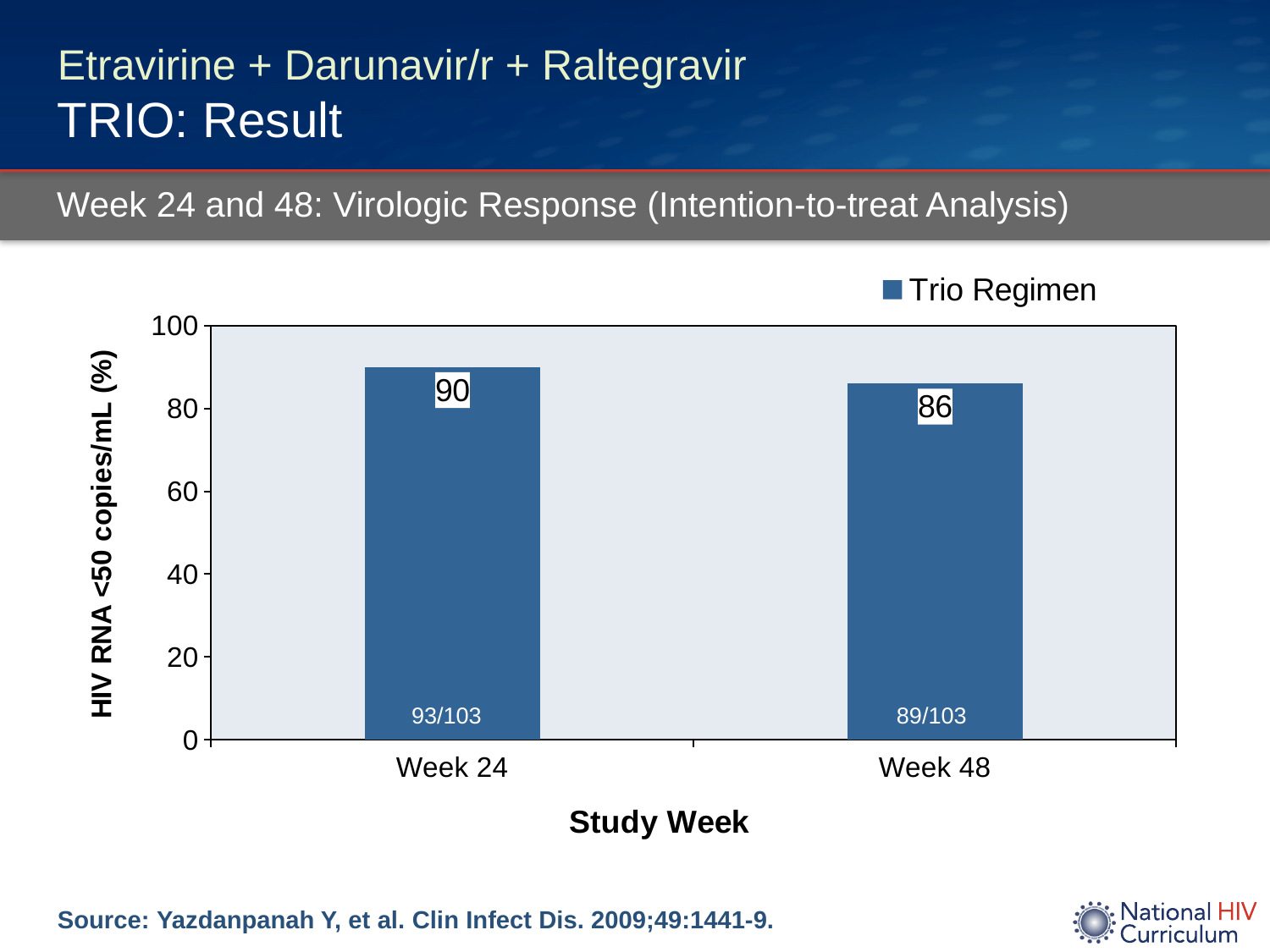
What is the value for Week 24? 90 How many study weeks are shown on the x axis? 2 Is the value for Week 48 greater or less than 80? greater Which study week has the highest value? Week 24 What is the name of the series in the legend? Trio Regimen How many series does the legend list? 1 What is the difference between the values for Week 24 and Week 48? 4 Do the values rise or fall from Week 24 to Week 48? fall Which is larger, the value for Week 24 or Week 48? Week 24 What is the value for Week 48? 86 Which study week has the lowest value? Week 48 What kind of chart is shown? bar chart